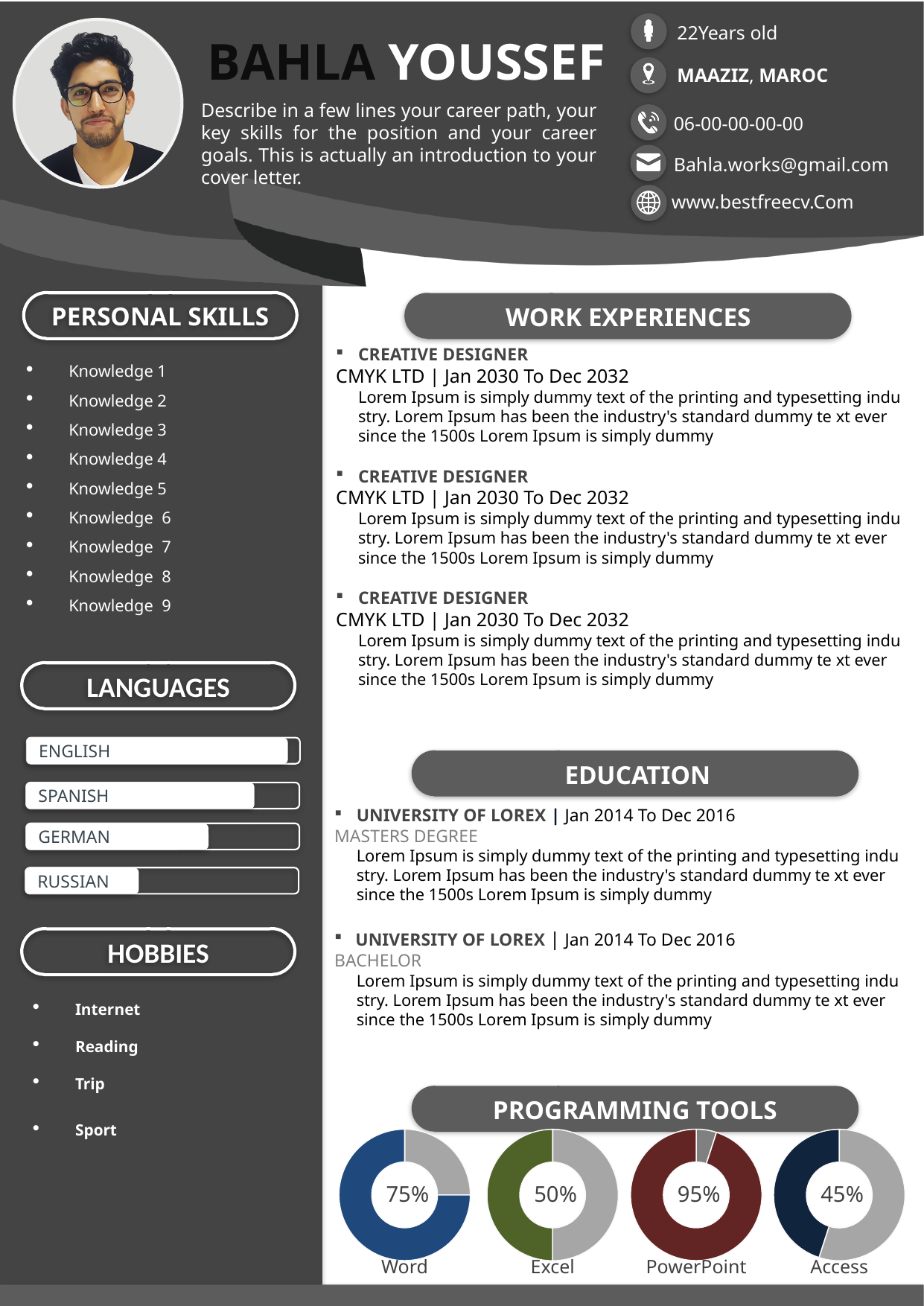
What colour is the filled portion of the PowerPoint donut chart? Dark red In the Programming Tools section, what percentage is shown for Excel? 50% In the Programming Tools section, what percentage is shown for Access? 45% How many donut charts are shown in the Programming Tools section? 4 In the Programming Tools section, which is larger, the percentage for Word or for Excel? Word In the Programming Tools section, what is the difference between the PowerPoint and Access percentages? 50% In the Programming Tools section, what percentage is shown for Word? 75% In the Programming Tools section, which tool has the lowest percentage? Access In the Programming Tools section, what percentage is shown for PowerPoint? 95% What kind of chart is used to show each programming tool's percentage? Donut chart In the Programming Tools section, which tool has the highest percentage? PowerPoint In the Programming Tools section, what is the difference between the Word and Excel percentages? 25%